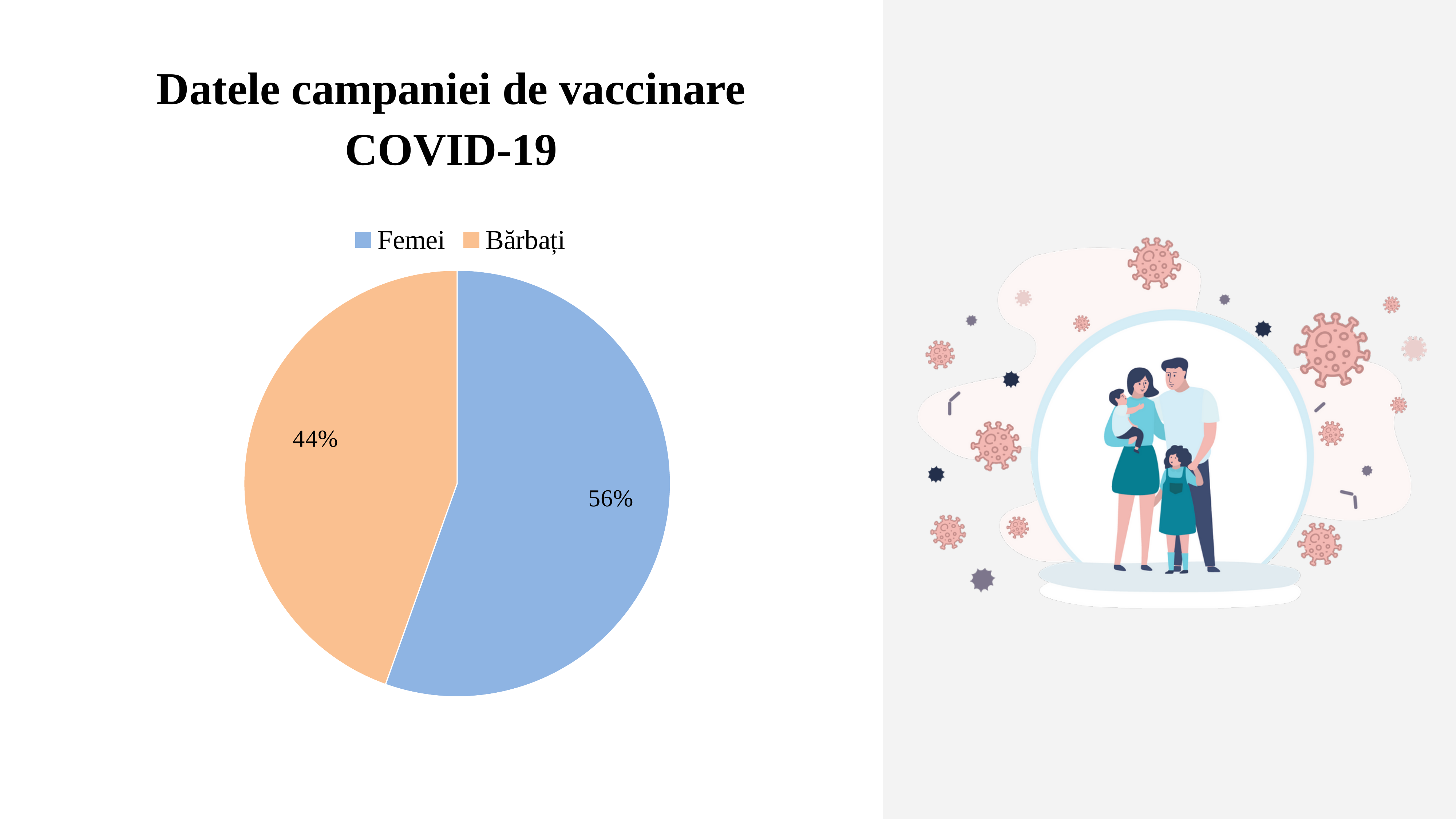
What colour is the Bărbați slice? Orange Which category has the smallest slice of the pie? Bărbați What is the title shown above the chart? Datele campaniei de vaccinare COVID-19 Which category has the largest slice of the pie? Femei What is the difference in percentage points between the Femei and Bărbați slices? 12 How many slices does the pie chart have? 2 What kind of chart is shown on the slide? Pie chart How many entries does the legend list? 2 What share of the pie does Femei represent? 56% Which slice is larger, Femei or Bărbați? Femei What share of the pie does Bărbați represent? 44%